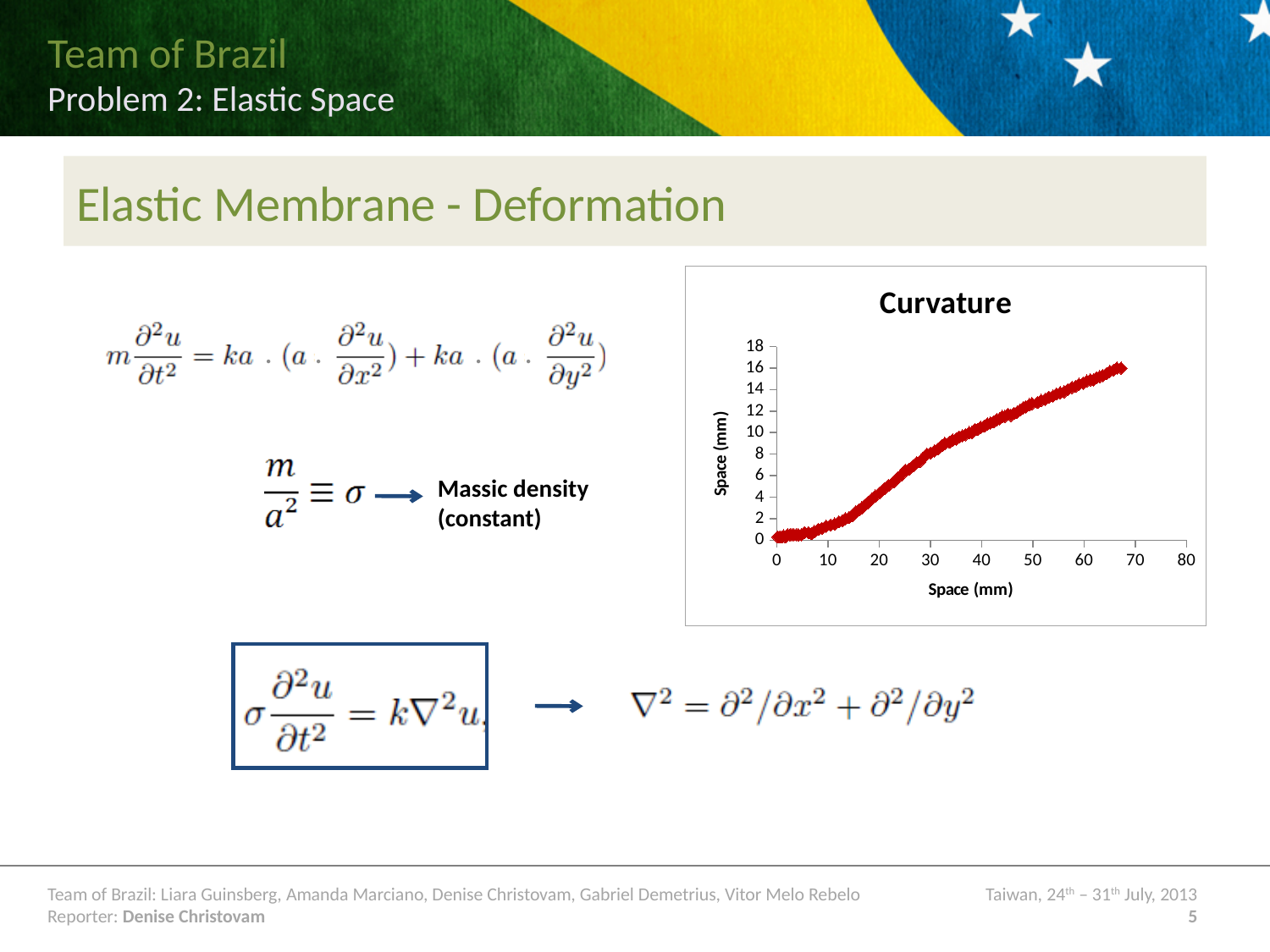
In the Curvature chart, is the value at x = 50 greater or less than 10? greater What is the label of the x axis of the Curvature chart? Space (mm) In the Curvature chart, do the values rise or fall as Space (mm) on the x axis increases? rise In the Curvature chart, is the value at x = 60 greater or less than 10? greater What is the title of the chart on the slide? Curvature In the Curvature chart, which has the larger value: the point at x = 60 or the point at x = 20? x = 60 In the Curvature chart, is the value at x = 30 greater or less than 6? greater What kind of chart is the Curvature chart? scatter chart